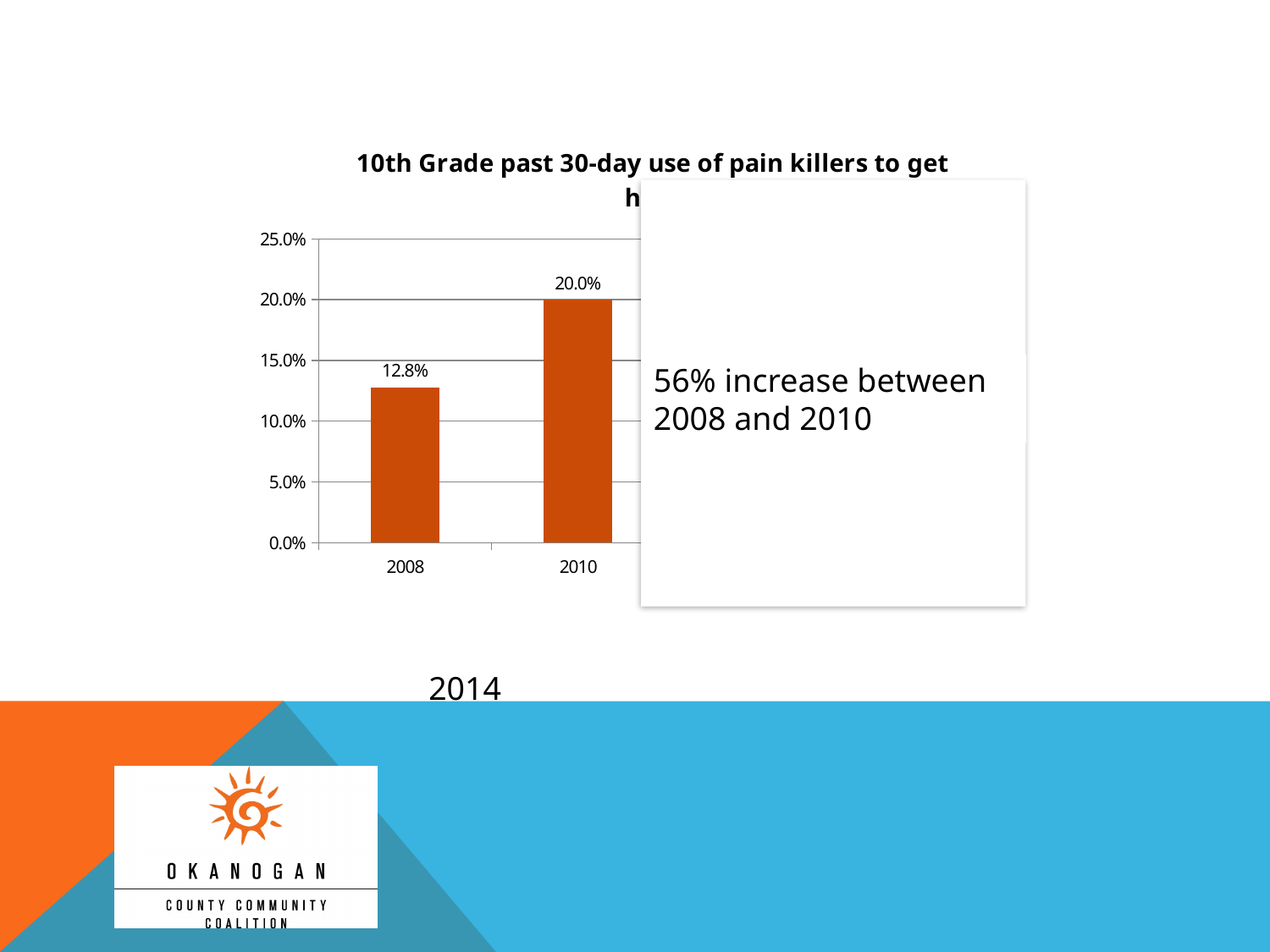
What is the value for 2008 in the chart? 12.8% What is the highest value shown on the chart's vertical axis? 25.0% Is the value for 2008 greater or less than 10.0%? greater Is the value for 2010 greater or less than 15.0%? greater Which is larger, the value for 2008 or the value for 2010? 2010 Does the value rise or fall from 2008 to 2010? rise What is the difference between the 2010 value and the 2008 value? 7.2% Is the value for 2008 greater or less than 15.0%? less What kind of chart is shown on the slide? bar chart What is the value for 2010 in the chart? 20.0% What colour are the bars in the chart? orange